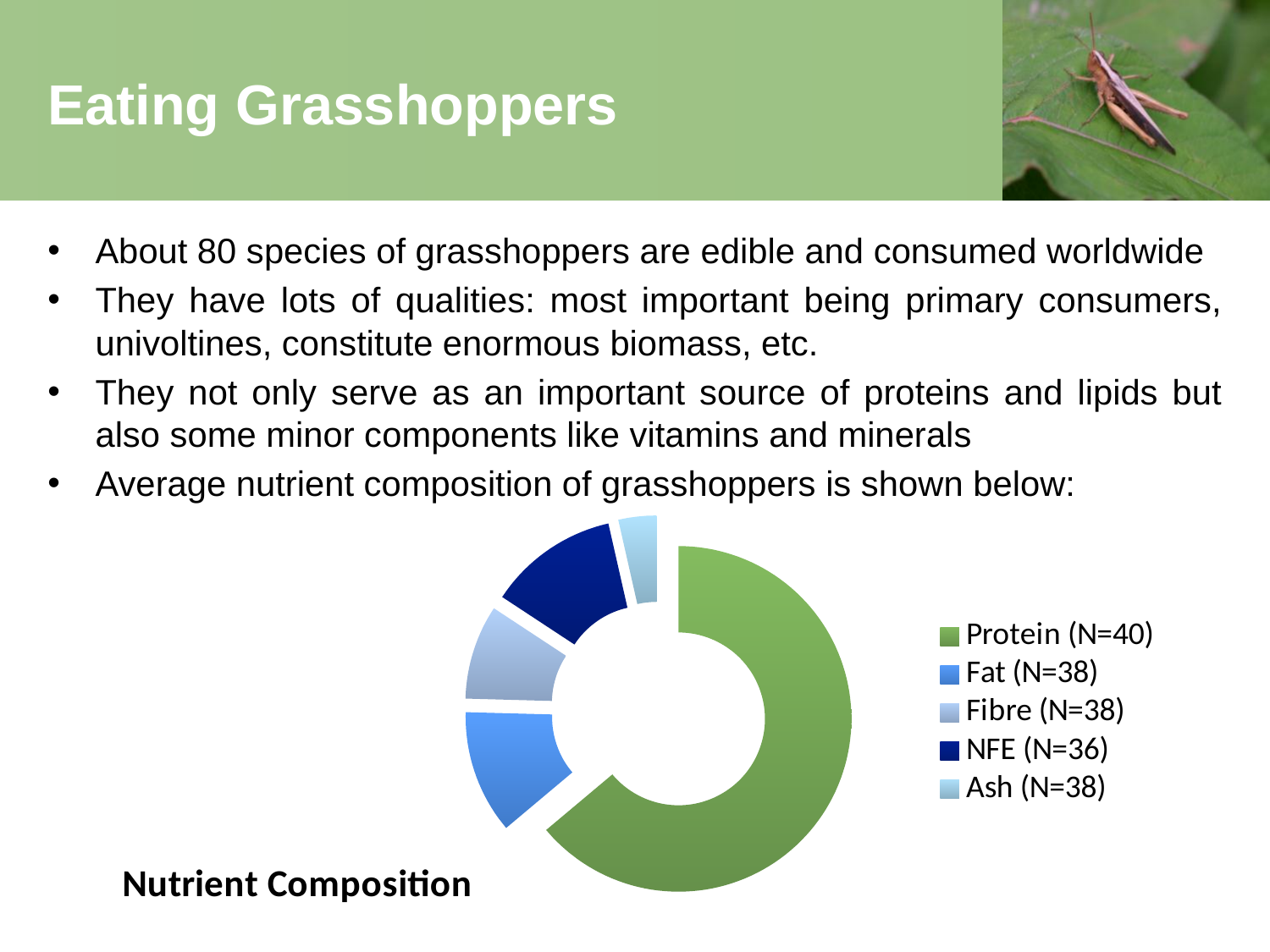
Which has the larger share in the chart, NFE or Ash? NFE How many categories does the Nutrient Composition chart show? 5 Which nutrient has the smallest share in the Nutrient Composition chart? Ash (N=38) Which has the larger share in the chart, Protein or Fat? Protein What colour is the Protein slice in the chart? Green What is the title of the chart? Nutrient Composition Which nutrient has the largest share in the Nutrient Composition chart? Protein (N=40) What sample size (N) is given for NFE in the chart legend? N=36 Which has the larger share in the chart, Fibre or Ash? Fibre What sample size (N) is given for Protein in the chart legend? N=40 What kind of chart is shown on the slide? Doughnut (pie) chart